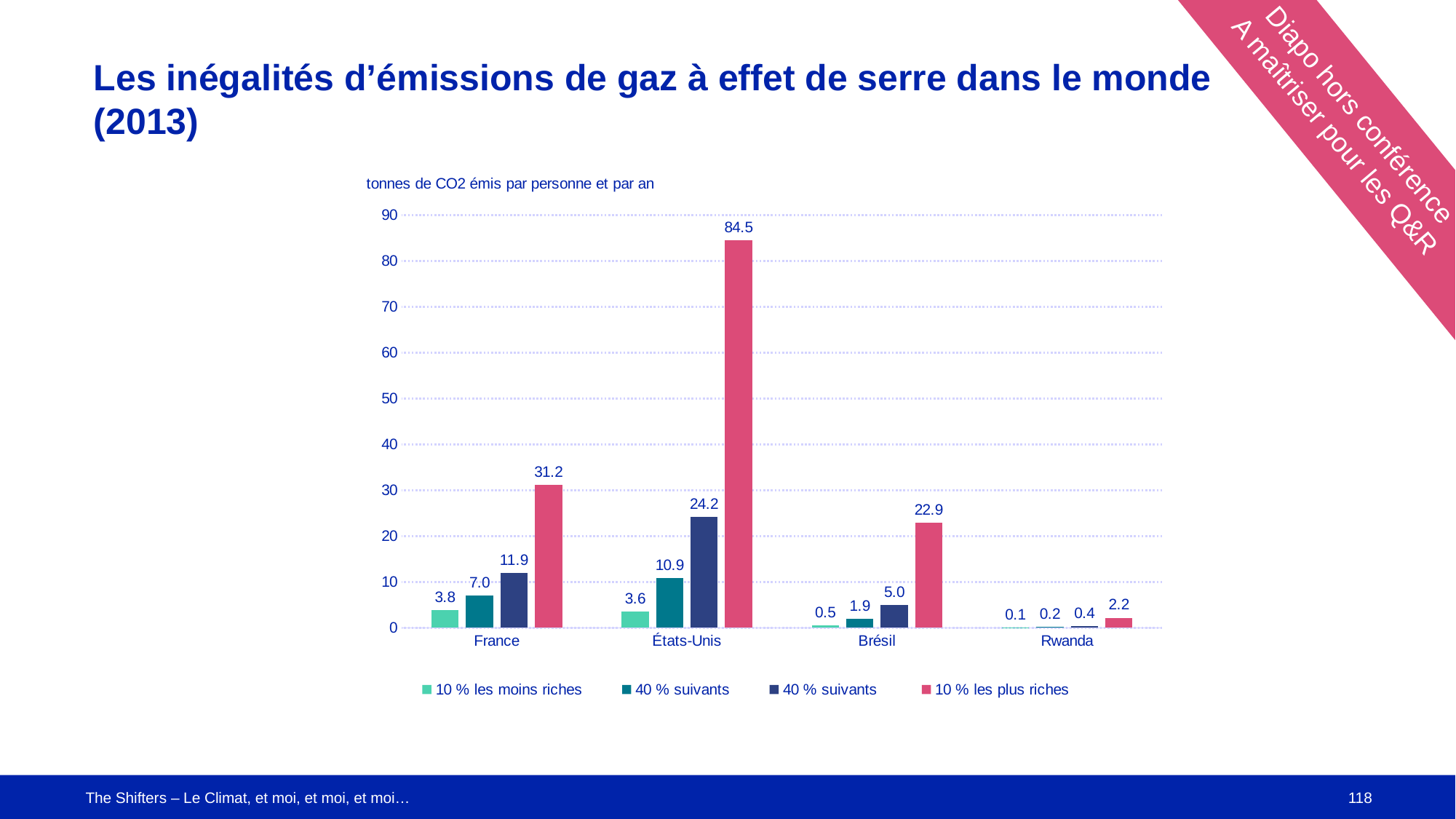
What is the value for the 10 % les plus riches in États-Unis? 84.5 How many series does the legend list? 4 Which country has the highest value for the 10 % les plus riches? États-Unis Which is larger: the 10 % les plus riches value for Brésil or for France? France What is the value for the 10 % les moins riches in Brésil? 0.5 What unit is given above the chart for the values? tonnes de CO2 émis par personne et par an What is the value for the 10 % les plus riches in Rwanda? 2.2 How many countries are shown on the x axis? 4 What is the difference between the 10 % les plus riches values for États-Unis and France? 53.3 Which country has the lowest value for the 10 % les moins riches? Rwanda What is the value for the 10 % les moins riches in France? 3.8 What kind of chart is shown on the slide? Bar chart